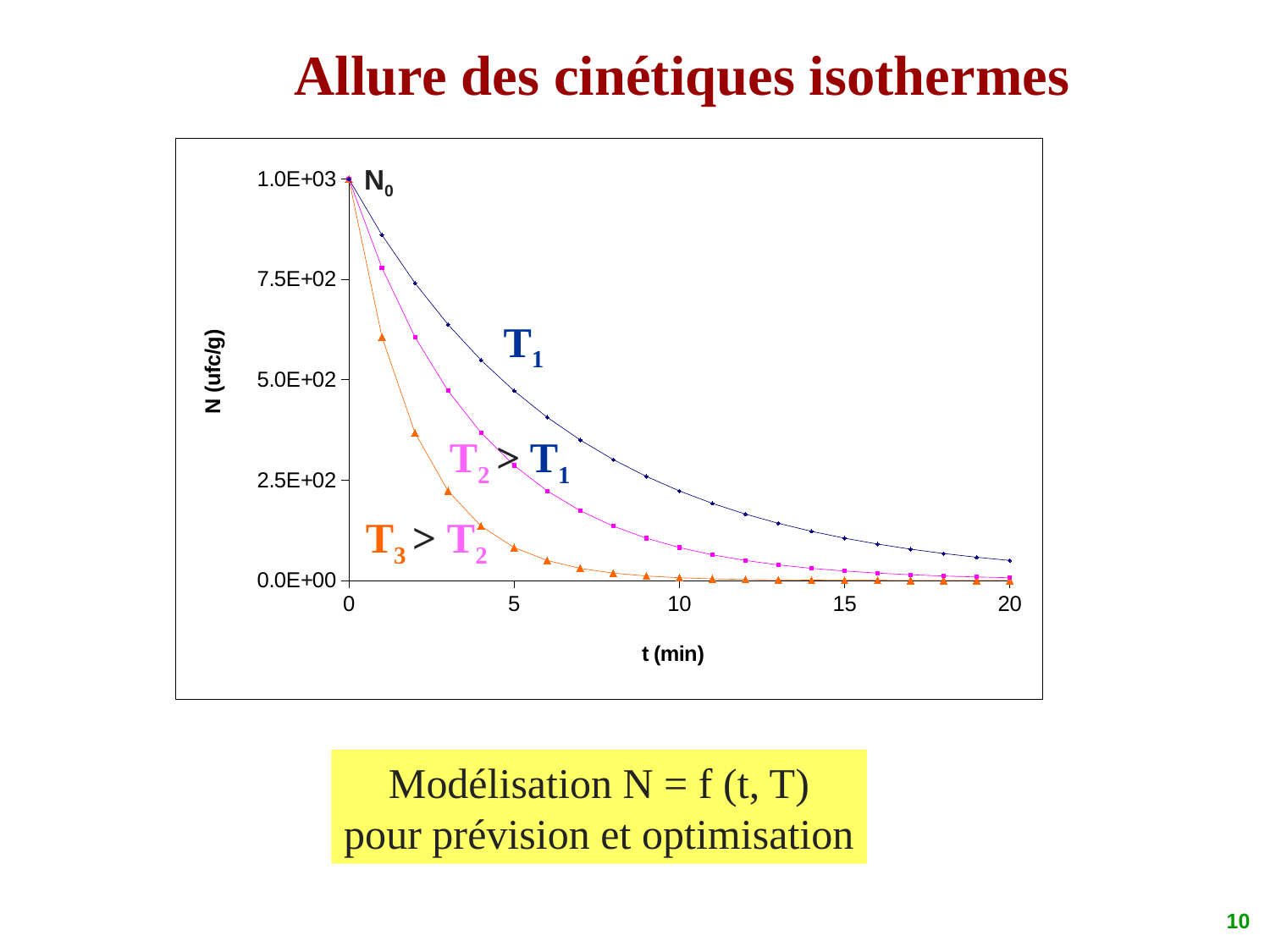
Which curve decreases the slowest? T1 What is the label of the y axis of the chart? N (ufc/g) Is the value of N for T3 at t = 5 min greater or less than 2.5E+02? less Is the value of N for T1 at t = 1 min greater or less than 7.5E+02? greater Do the values of N rise or fall as t increases? fall At t = 5 min, which curve has the larger value of N, T1 or T3? T1 What is the title of the chart on the slide? Allure des cinétiques isothermes How many curves are plotted on the chart? 3 What kind of chart is shown on the slide? line chart What is the value of N at t = 0 for all three curves? 1.0E+03 Which curve decreases the fastest? T3 Is the value of N for T1 at t = 10 min greater or less than 2.5E+02? less